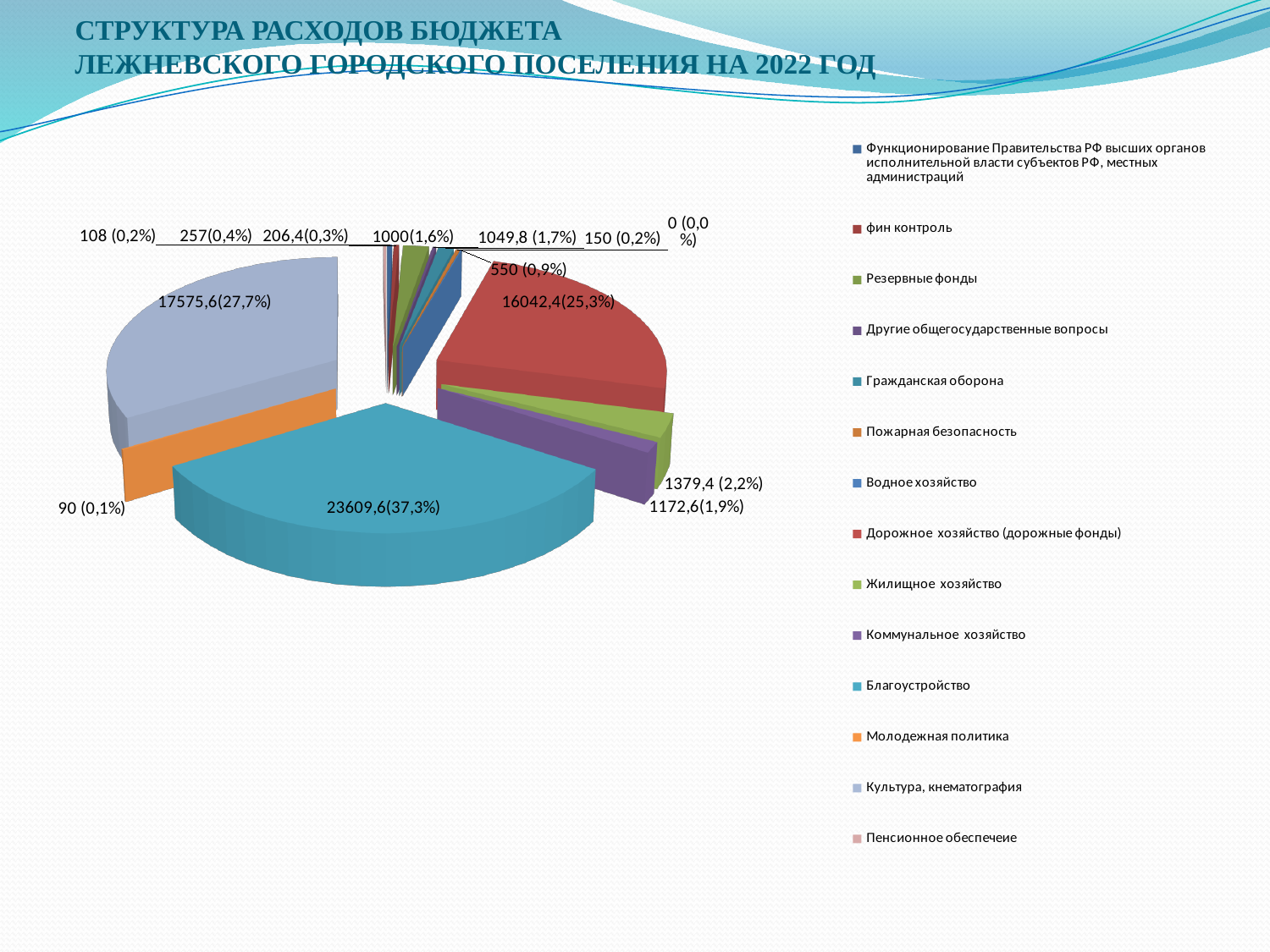
What is the smallest value labelled on the pie chart? 0 (0,0%) Which category has the largest slice of the pie chart? Благоустройство What kind of chart is shown on the slide? pie chart What is the difference between the Благоустройство value (23609,6) and the Дорожное хозяйство value (16042,4)? 7567,2 What value is shown for Культура, кнематография? 17575,6(27,7%) What value is shown for the largest slice of the pie chart? 23609,6(37,3%) What is the title of the slide containing the pie chart? СТРУКТУРА РАСХОДОВ БЮДЖЕТА ЛЕЖНЕВСКОГО ГОРОДСКОГО ПОСЕЛЕНИЯ НА 2022 ГОД What value is shown for Дорожное хозяйство (дорожные фонды)? 16042,4(25,3%) What share of the pie does the Благоустройство slice represent? 37,3% What value is shown for Молодежная политика? 90 (0,1%) How many entries does the legend of the pie chart list? 14 Which is larger: the slice for Культура, кнематография or the slice for Дорожное хозяйство (дорожные фонды)? Культура, кнематография